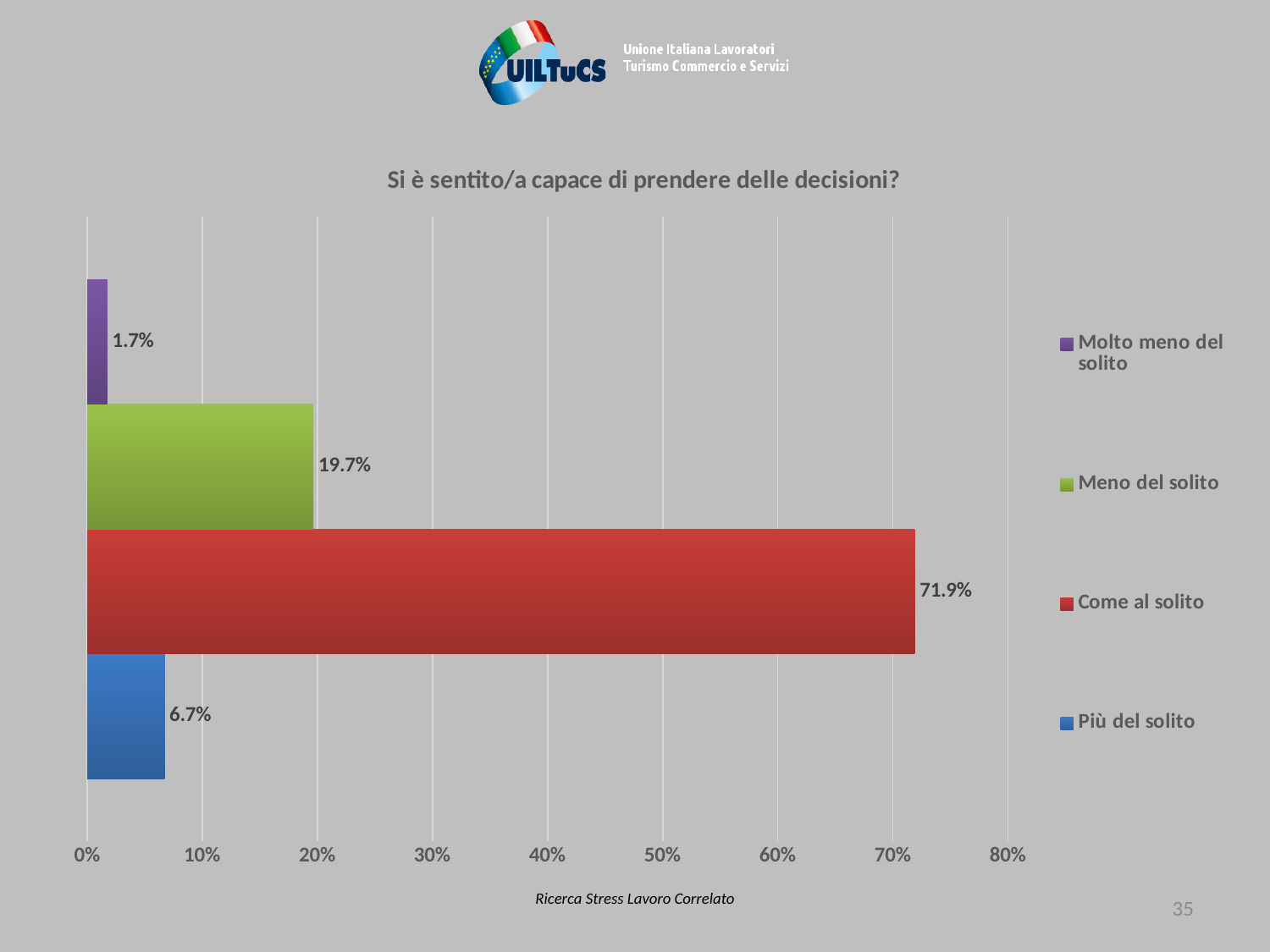
Which category has the highest value? Come al solito What is the value for "Più del solito"? 6.7% Which category has the lowest value? Molto meno del solito How many categories are shown in the chart? 4 Which is larger, the value for "Più del solito" or the value for "Meno del solito"? Meno del solito What is the title of the chart? Si è sentito/a capace di prendere delle decisioni? What is the difference between the values for "Come al solito" and "Meno del solito"? 52.2% What is the value for "Molto meno del solito"? 1.7% Is the value for "Come al solito" greater or less than 70%? greater What is the value for "Come al solito"? 71.9% What kind of chart is shown on the slide? Bar chart What is the value for "Meno del solito"? 19.7%